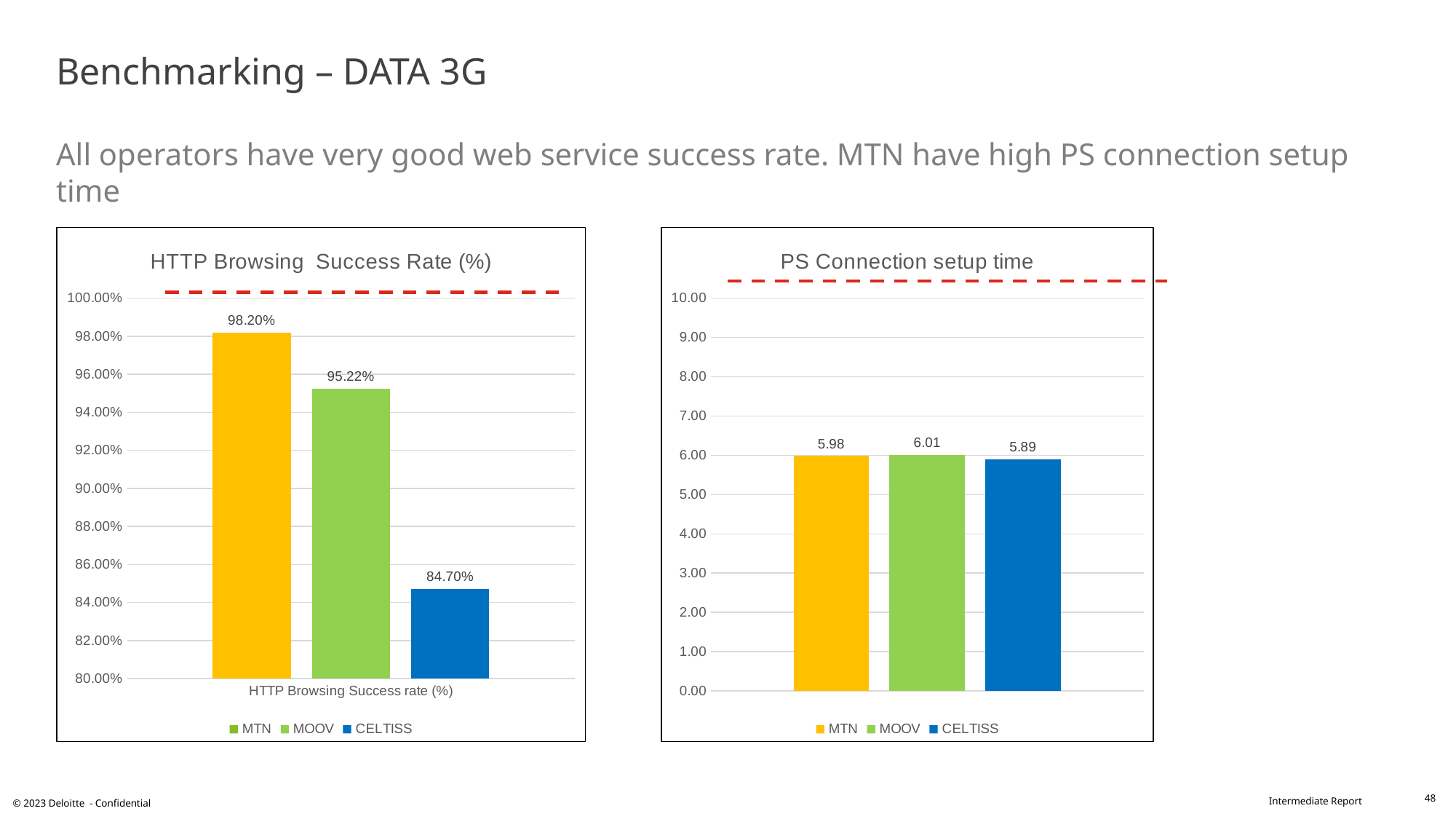
What kind of chart is the PS Connection setup time chart? Bar chart In the HTTP Browsing Success Rate (%) chart, which is larger, the value for MOOV or the value for CELTISS? MOOV In the HTTP Browsing Success Rate (%) chart, which operator has the lowest success rate? CELTISS In the HTTP Browsing Success Rate (%) chart, what is the value for MTN? 98.20% In the HTTP Browsing Success Rate (%) chart, which operator has the highest success rate? MTN In the HTTP Browsing Success Rate (%) chart, what is the value for CELTISS? 84.70% How many series does the legend of the PS Connection setup time chart list? 3 In the PS Connection setup time chart, what is the value for CELTISS? 5.89 In the HTTP Browsing Success Rate (%) chart, what is the difference between the MTN and CELTISS values? 13.50% In the PS Connection setup time chart, is the value for MTN greater or less than 7.00? less In the PS Connection setup time chart, what is the difference between the MOOV and CELTISS values? 0.12 In the PS Connection setup time chart, what is the value for MOOV? 6.01